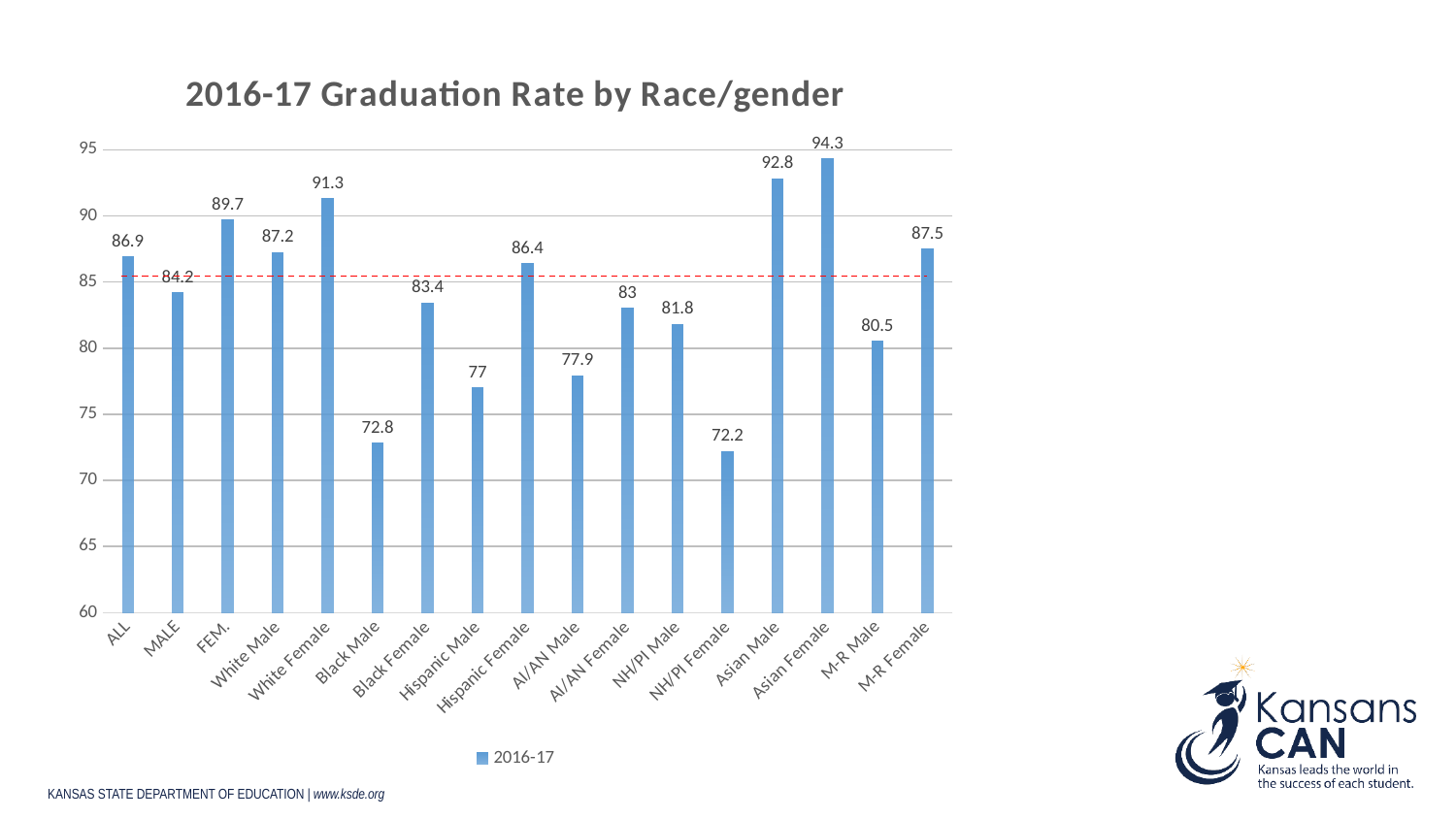
Which category has the highest graduation rate? Asian Female What kind of chart is shown on the slide? bar chart What is the difference between the graduation rates of Asian Female and Asian Male? 1.5 Which has a higher graduation rate, Black Female or Hispanic Female? Hispanic Female What is the graduation rate for NH/PI Female? 72.2 Is the value for Black Male greater or less than 75? less What is the graduation rate for the ALL category? 86.9 What is the graduation rate for White Female? 91.3 How many series does the legend list? 1 Which category has the lowest graduation rate? NH/PI Female How many categories are shown on the x axis? 17 What is the title of the chart? 2016-17 Graduation Rate by Race/gender